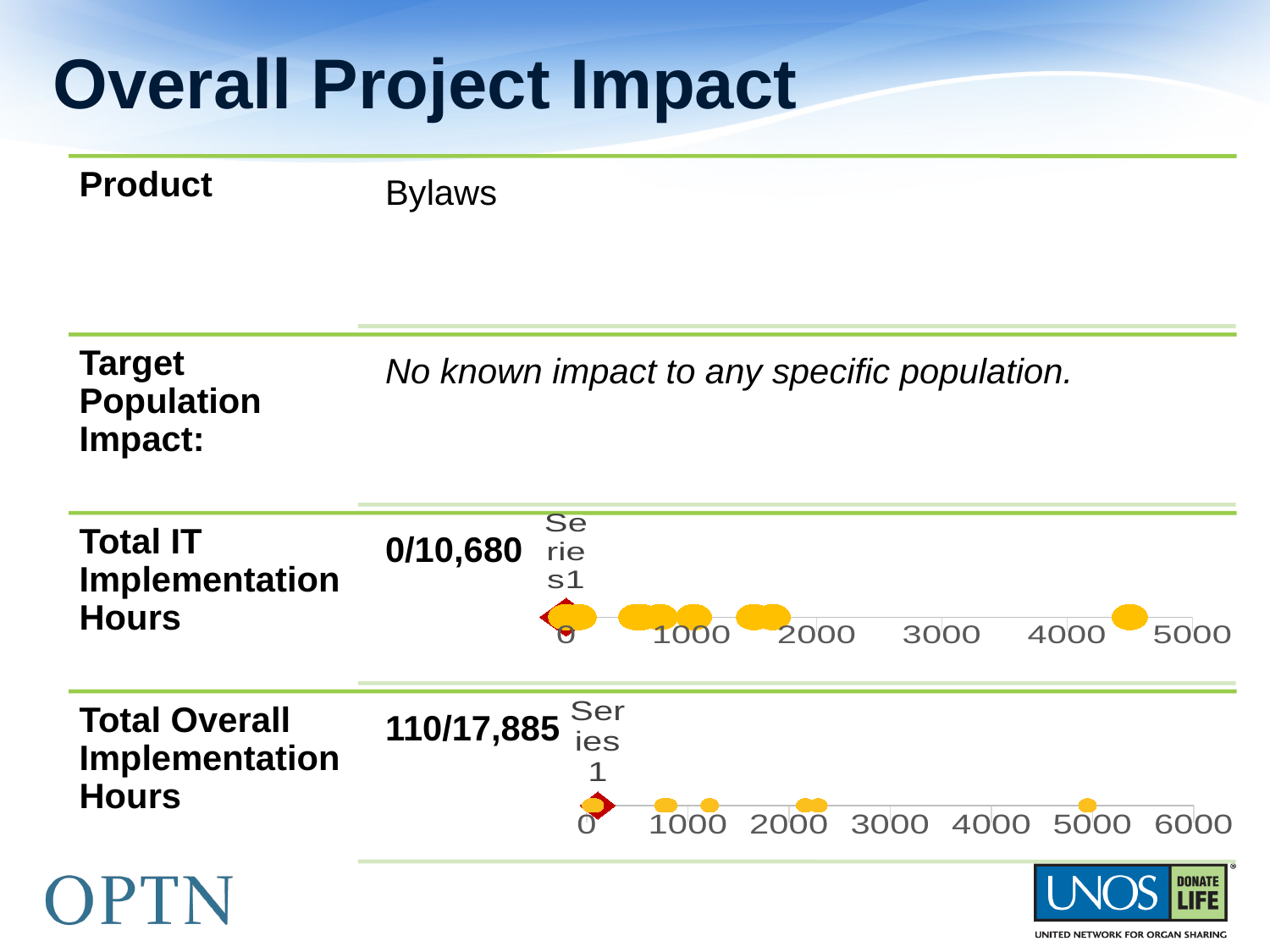
In the chart next to "Total Overall Implementation Hours", what is the highest value labelled on the x axis? 6000 In the chart next to "Total IT Implementation Hours", is the rightmost yellow point greater or less than 3000? greater What kind of chart is shown next to "Total IT Implementation Hours"? scatter (dot) chart How many tick labels are shown on the x axis of the chart next to "Total Overall Implementation Hours"? 7 In the chart next to "Total IT Implementation Hours", is the red diamond marker greater or less than 1000? less In the chart next to "Total IT Implementation Hours", is the rightmost yellow point greater or less than 4000? greater In the chart next to "Total IT Implementation Hours", what is the highest value labelled on the x axis? 5000 How many tick labels are shown on the x axis of the chart next to "Total IT Implementation Hours"? 6